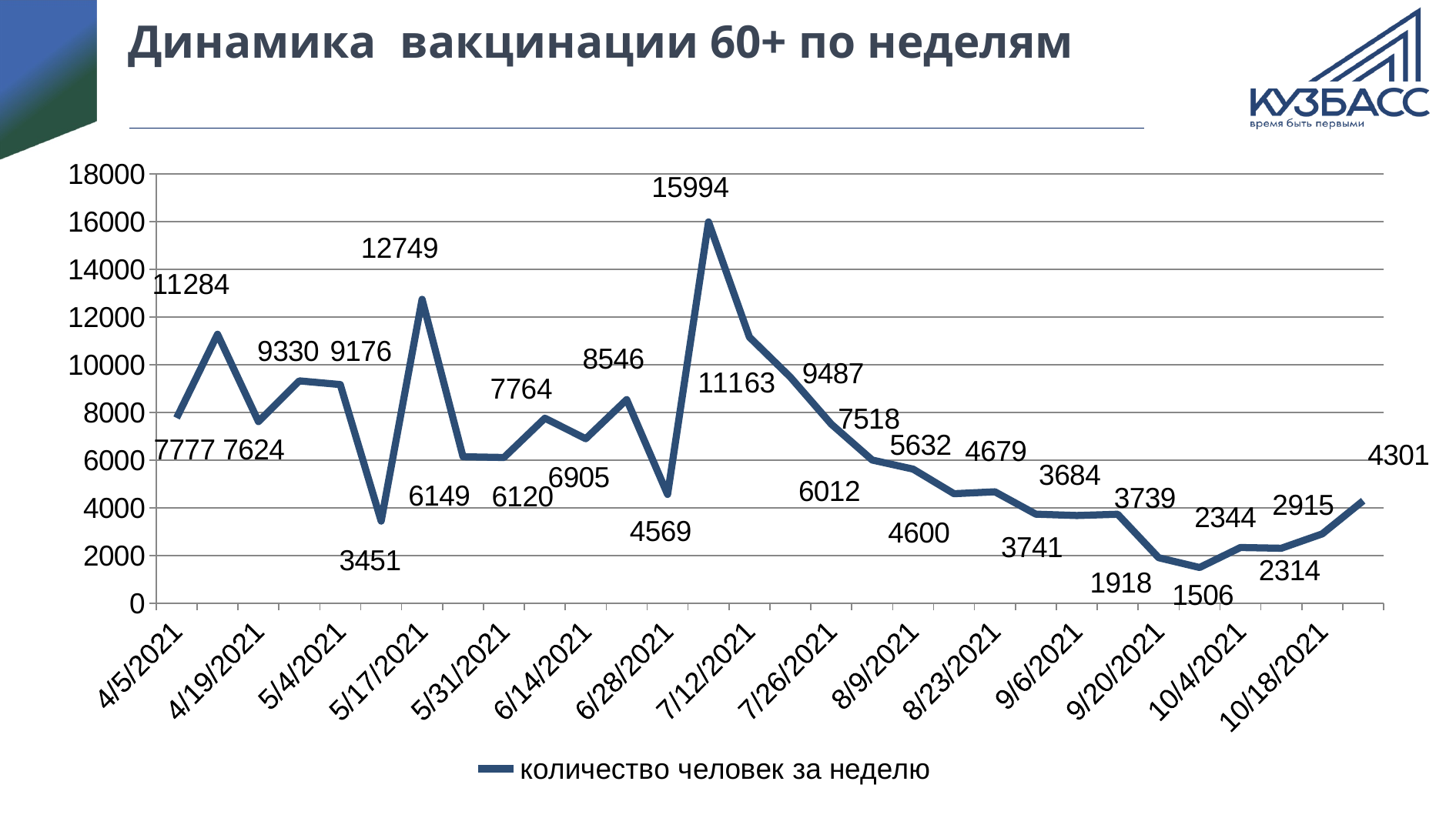
What is the value for 10/18/2021? 2915 What is the value for 4/5/2021? 7777 Do the values rise or fall from 7/12/2021 to 9/20/2021? fall What is the highest value plotted on the chart? 15994 Which is larger, the value for 4/19/2021 or the value for 5/4/2021? 5/4/2021 Is the value for 6/28/2021 greater or less than 6000? less What is the lowest value plotted on the chart? 1506 What is the difference between the values for 5/17/2021 and 5/31/2021? 6629 What is the value for 5/17/2021? 12749 What kind of chart is shown on the slide? line chart How many series does the legend list? 1 What is the value for 9/20/2021? 1918